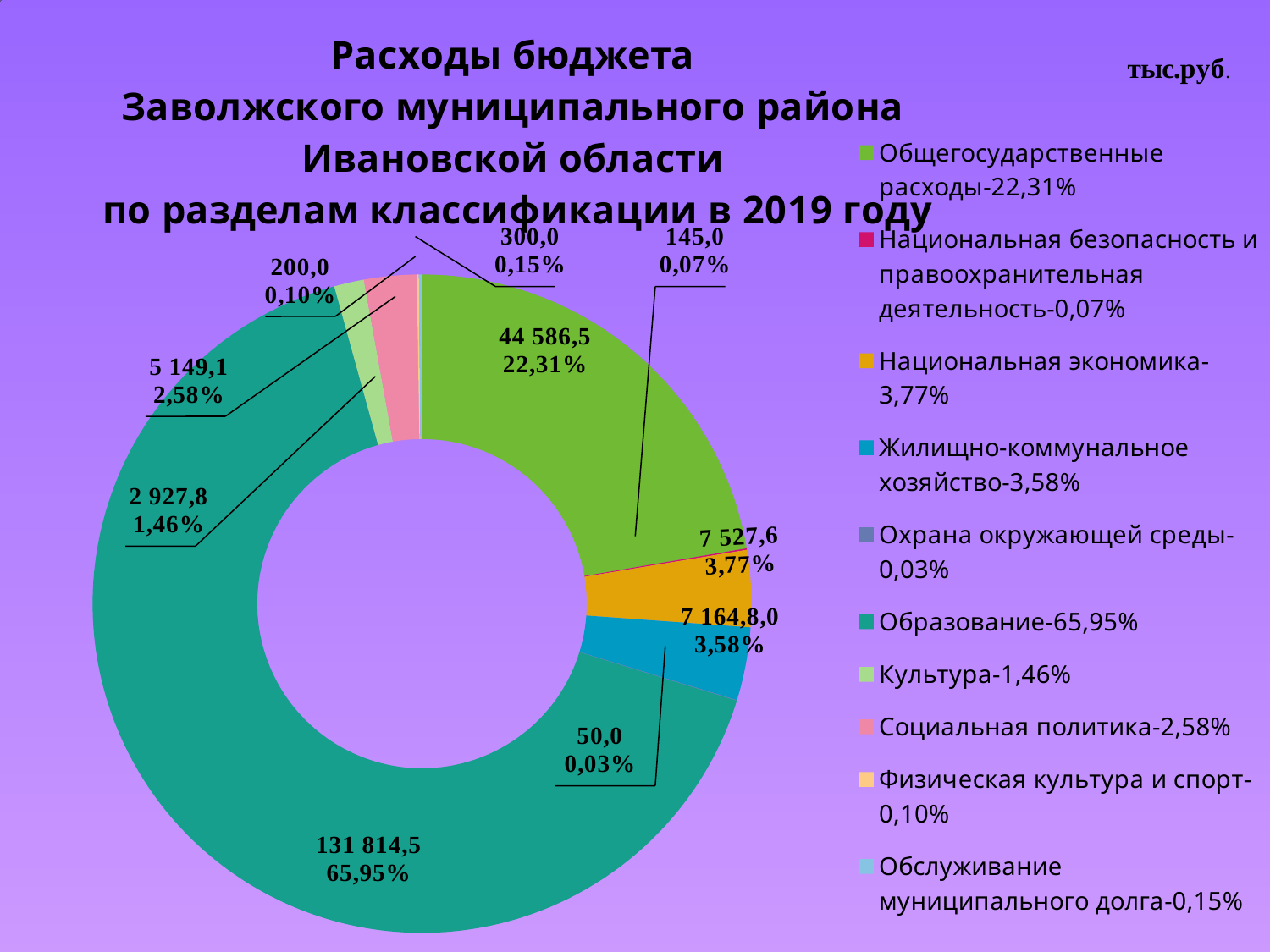
What kind of chart is shown on the slide? doughnut chart What share of the pie does Жилищно-коммунальное хозяйство take? 3,58% What share of the pie does Образование take? 65,95% Which category has the largest slice? Образование What unit is indicated in the top right corner of the slide? тыс.руб. What is the value for Общегосударственные расходы? 44 586,5 What is the value for Национальная экономика? 7 527,6 What is the value for Образование? 131 814,5 What is the difference between the values for Национальная экономика and Социальная политика? 2 378,5 Which category has the smallest slice? Охрана окружающей среды Which is larger, the value for Обслуживание муниципального долга or the value for Физическая культура и спорт? Обслуживание муниципального долга How many categories does the legend list? 10